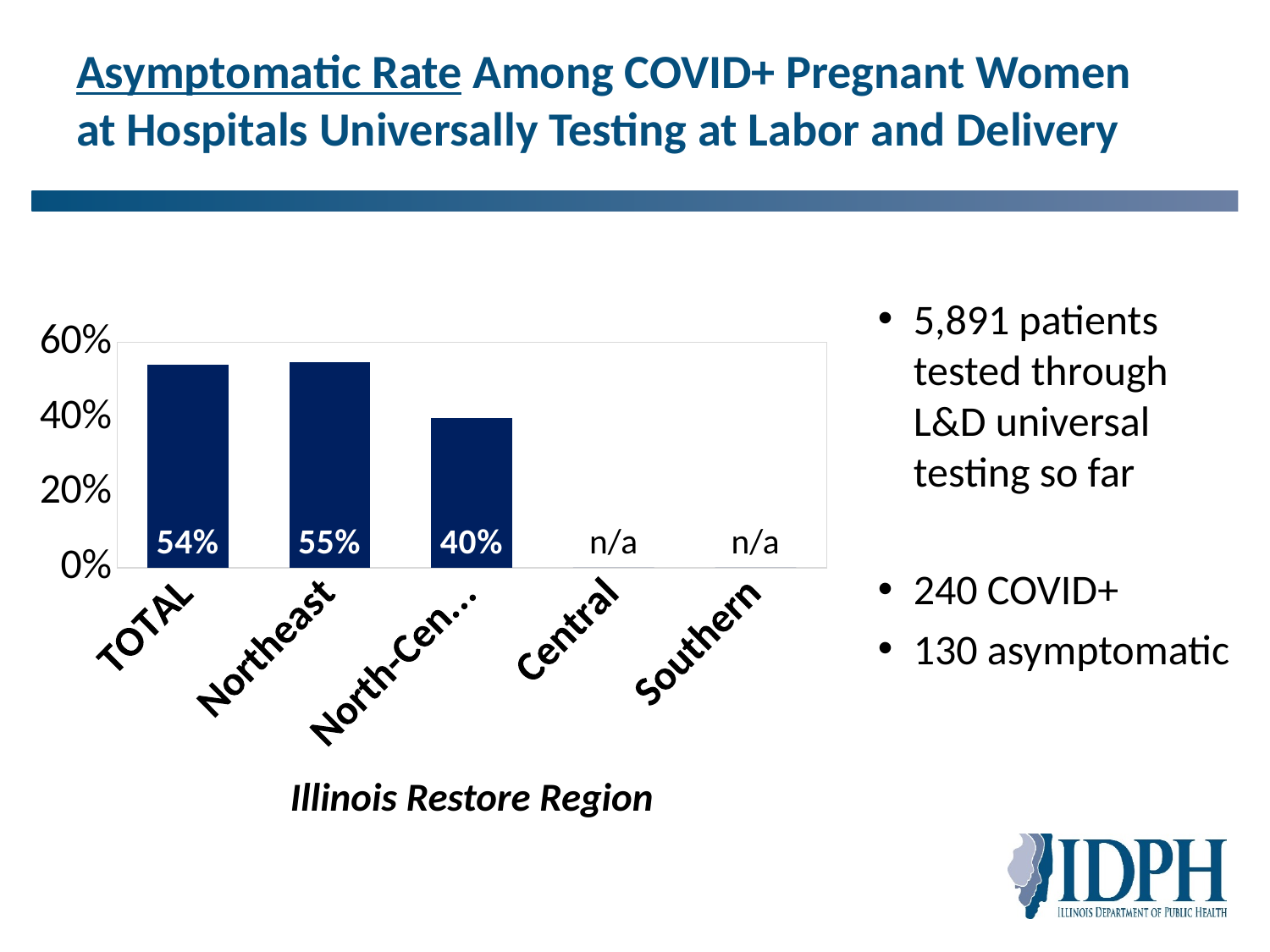
What value is shown for the third bar (the region labelled "North-Cen…")? 40% What is the difference between the Northeast value and the value for the third bar (North-Cen…)? 15 percentage points What kind of chart is shown on the slide? bar chart What value is shown for the Southern region? n/a What value is shown for the Central region? n/a Among the categories with a percentage shown, which has the lowest value? North-Cen… What is the asymptomatic rate shown for the Northeast region? 55% Which category has the highest asymptomatic rate shown? Northeast How many categories are shown on the x axis? 5 Which is larger, the value for TOTAL or the value for the third bar (North-Cen…)? TOTAL What is the title of the x axis? Illinois Restore Region What is the asymptomatic rate shown for TOTAL? 54%